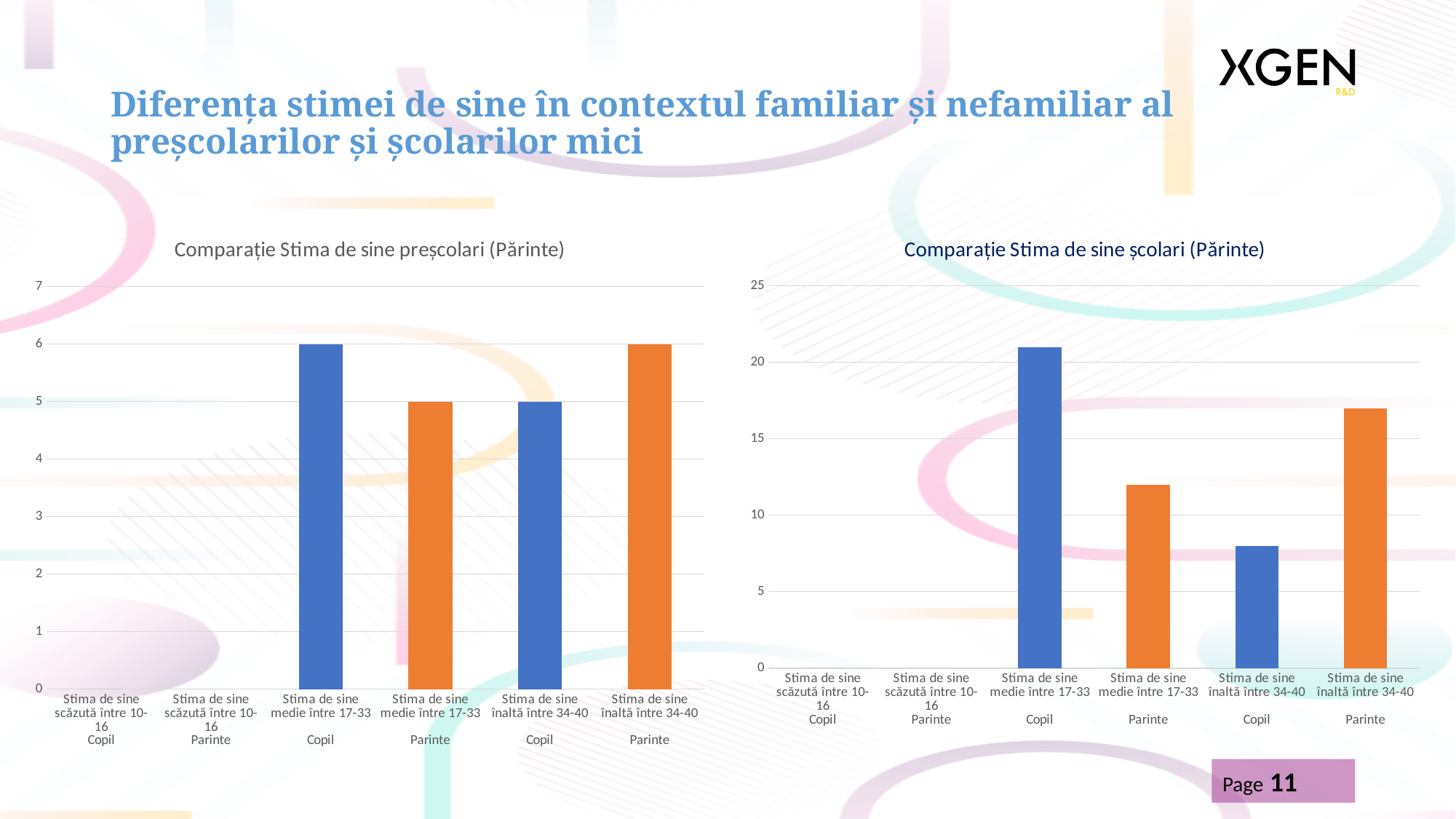
In the left chart 'Comparație Stima de sine preșcolari (Părinte)', what is the difference between 'Stima de sine înaltă între 34-40 Parinte' and 'Stima de sine înaltă între 34-40 Copil'? 1 In the right chart 'Comparație Stima de sine școlari (Părinte)', which category has the highest value? Stima de sine medie între 17-33 Copil In the left chart 'Comparație Stima de sine preșcolari (Părinte)', what is the value for 'Stima de sine medie între 17-33 Parinte'? 5 How many categories are shown on the x axis of the right chart 'Comparație Stima de sine școlari (Părinte)'? 6 What is the highest value shown on the y axis of the right chart 'Comparație Stima de sine școlari (Părinte)'? 25 In the left chart 'Comparație Stima de sine preșcolari (Părinte)', what is the value for 'Stima de sine înaltă între 34-40 Parinte'? 6 What kind of chart is the left chart, 'Comparație Stima de sine preșcolari (Părinte)'? bar chart In the left chart 'Comparație Stima de sine preșcolari (Părinte)', what is the value for 'Stima de sine medie între 17-33 Copil'? 6 In the right chart 'Comparație Stima de sine școlari (Părinte)', is the value for 'Stima de sine medie între 17-33 Copil' greater or less than 20? greater In the left chart 'Comparație Stima de sine preșcolari (Părinte)', which is larger: 'Stima de sine medie între 17-33 Copil' or 'Stima de sine medie între 17-33 Parinte'? Stima de sine medie între 17-33 Copil In the right chart 'Comparație Stima de sine școlari (Părinte)', which is larger: 'Stima de sine înaltă între 34-40 Parinte' or 'Stima de sine medie între 17-33 Parinte'? Stima de sine înaltă între 34-40 Parinte In the right chart 'Comparație Stima de sine școlari (Părinte)', is the value for 'Stima de sine înaltă între 34-40 Copil' greater or less than 10? less